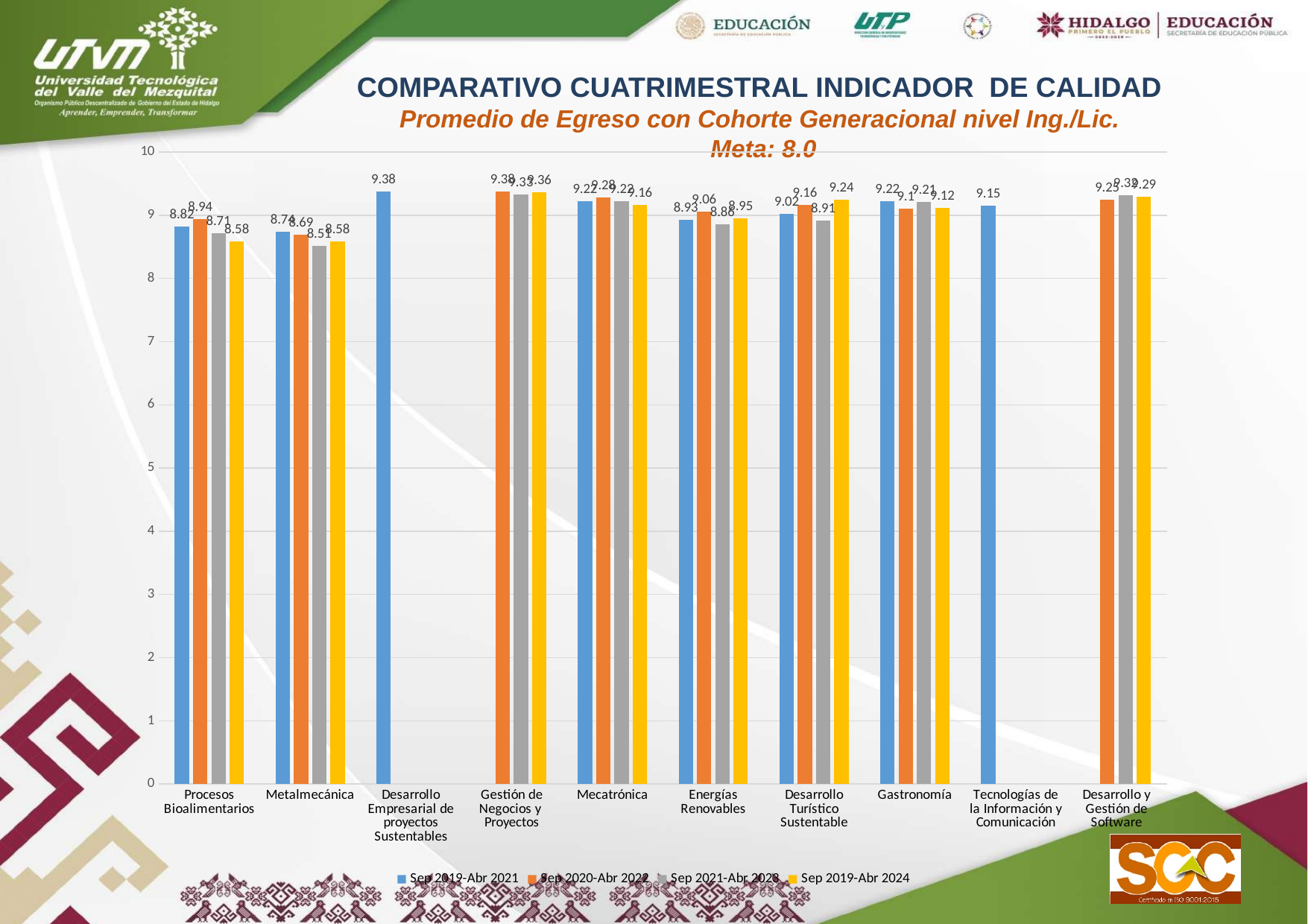
What is the value for Tecnologías de la Información y Comunicación in the Sep 2019-Abr 2021 series? 9.15 How many program categories are shown on the x axis? 10 For Metalmecánica, which series has the lowest value? Sep 2021-Abr 2023 Is the value for Metalmecánica in the Sep 2021-Abr 2023 series greater or less than 9? less For Metalmecánica, which is larger: the Sep 2019-Abr 2021 value or the Sep 2021-Abr 2023 value? Sep 2019-Abr 2021 For Procesos Bioalimentarios, what is the difference between the Sep 2020-Abr 2022 value and the Sep 2019-Abr 2024 value? 0.36 What is the value for Desarrollo Turístico Sustentable in the Sep 2019-Abr 2024 series? 9.24 What is the value for Mecatrónica in the Sep 2020-Abr 2022 series? 9.28 What kind of chart is shown on the slide? bar chart How many series does the legend list? 4 What is the value for Desarrollo Empresarial de proyectos Sustentables in the Sep 2019-Abr 2021 series? 9.38 For Desarrollo Turístico Sustentable, which series has the highest value? Sep 2019-Abr 2024